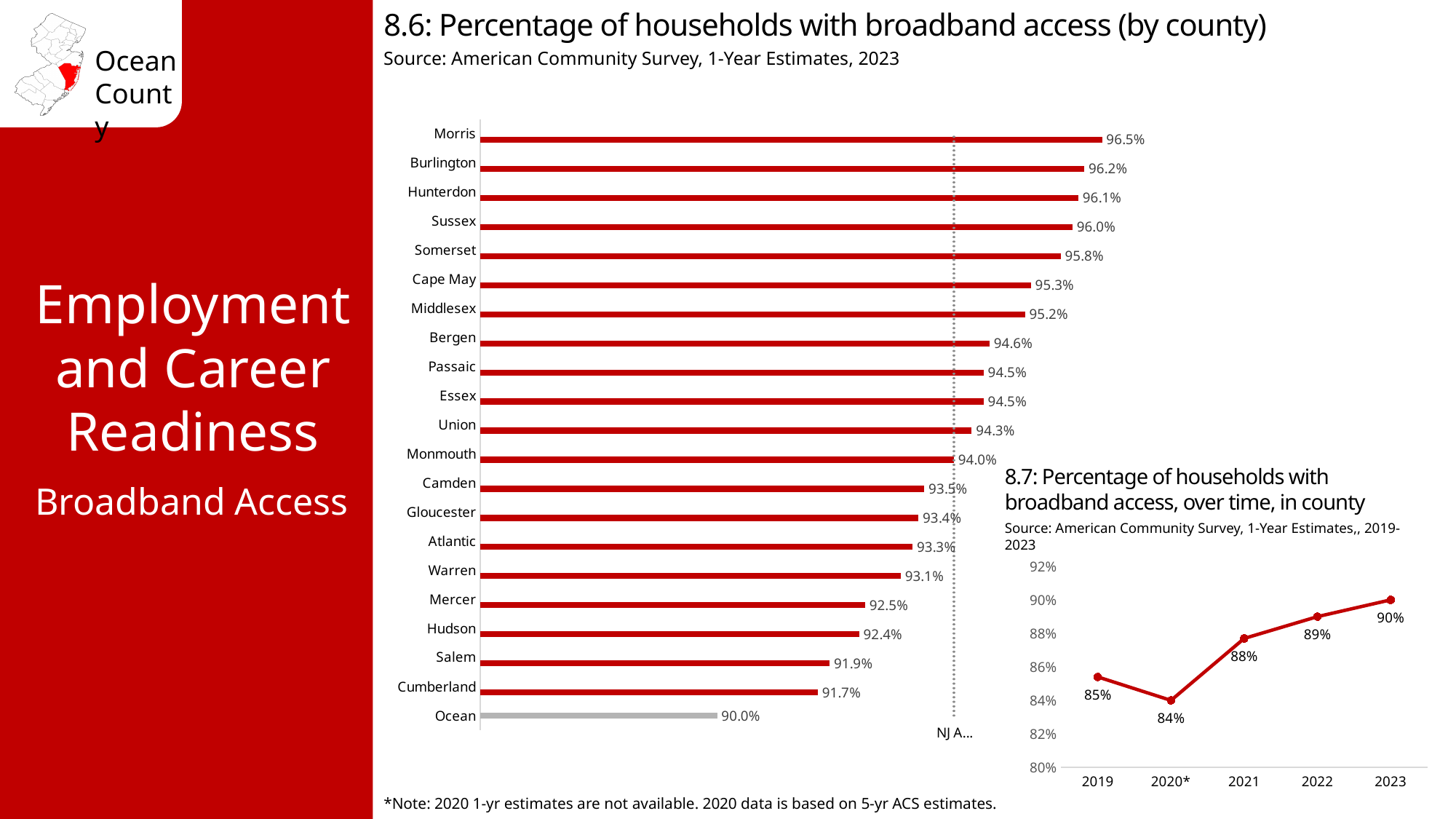
In chart 8.6 (Percentage of households with broadband access by county), what is the value for Ocean? 90.0% In chart 8.7 (broadband access over time in county), what is the difference between 2023 and 2019? 5 percentage points In chart 8.6 (by county), which county has the lowest percentage of households with broadband access? Ocean What kind of chart is chart 8.7 (Percentage of households with broadband access over time in county)? Line chart In chart 8.6 (by county), which county has the highest percentage of households with broadband access? Morris In chart 8.6 (by county), what is the value for Cape May? 95.3% In chart 8.6 (by county), what is the difference between Morris and Ocean? 6.5 percentage points In chart 8.6 (by county), how many counties are shown? 21 What kind of chart is chart 8.6 (Percentage of households with broadband access by county)? Bar chart In chart 8.7 (broadband access over time in county), what is the value for 2021? 88% In chart 8.7 (broadband access over time in county), which year has the lowest value? 2020* In chart 8.6 (by county), which is larger, the value for Bergen or the value for Camden? Bergen